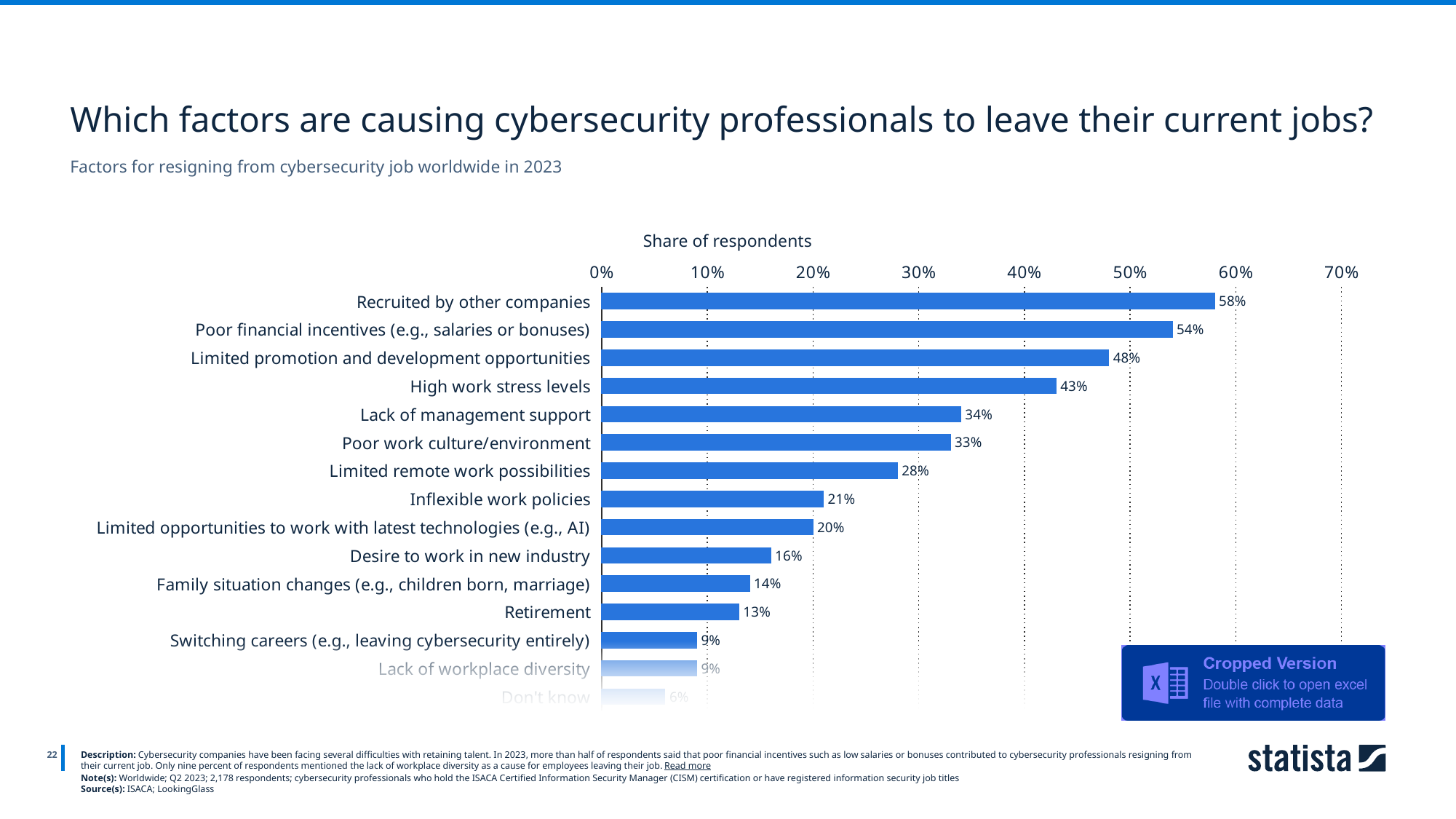
What kind of chart is shown on the slide? Bar chart Which factor has the highest share of respondents? Recruited by other companies Is the value for 'Inflexible work policies' greater or less than 20%? greater What share of respondents cited 'Limited remote work possibilities'? 28% What is the difference between 'Poor financial incentives (e.g., salaries or bonuses)' and 'Limited promotion and development opportunities'? 6% What is the value for 'High work stress levels'? 43% What is the value shown for 'Retirement'? 13% What share of respondents cited being recruited by other companies as a factor for resigning? 58% Which is larger: 'Lack of management support' or 'Poor work culture/environment'? Lack of management support What is the difference between 'Recruited by other companies' and 'High work stress levels'? 15% What is the label of the horizontal axis? Share of respondents Which is larger: 'Desire to work in new industry' or 'Family situation changes (e.g., children born, marriage)'? Desire to work in new industry